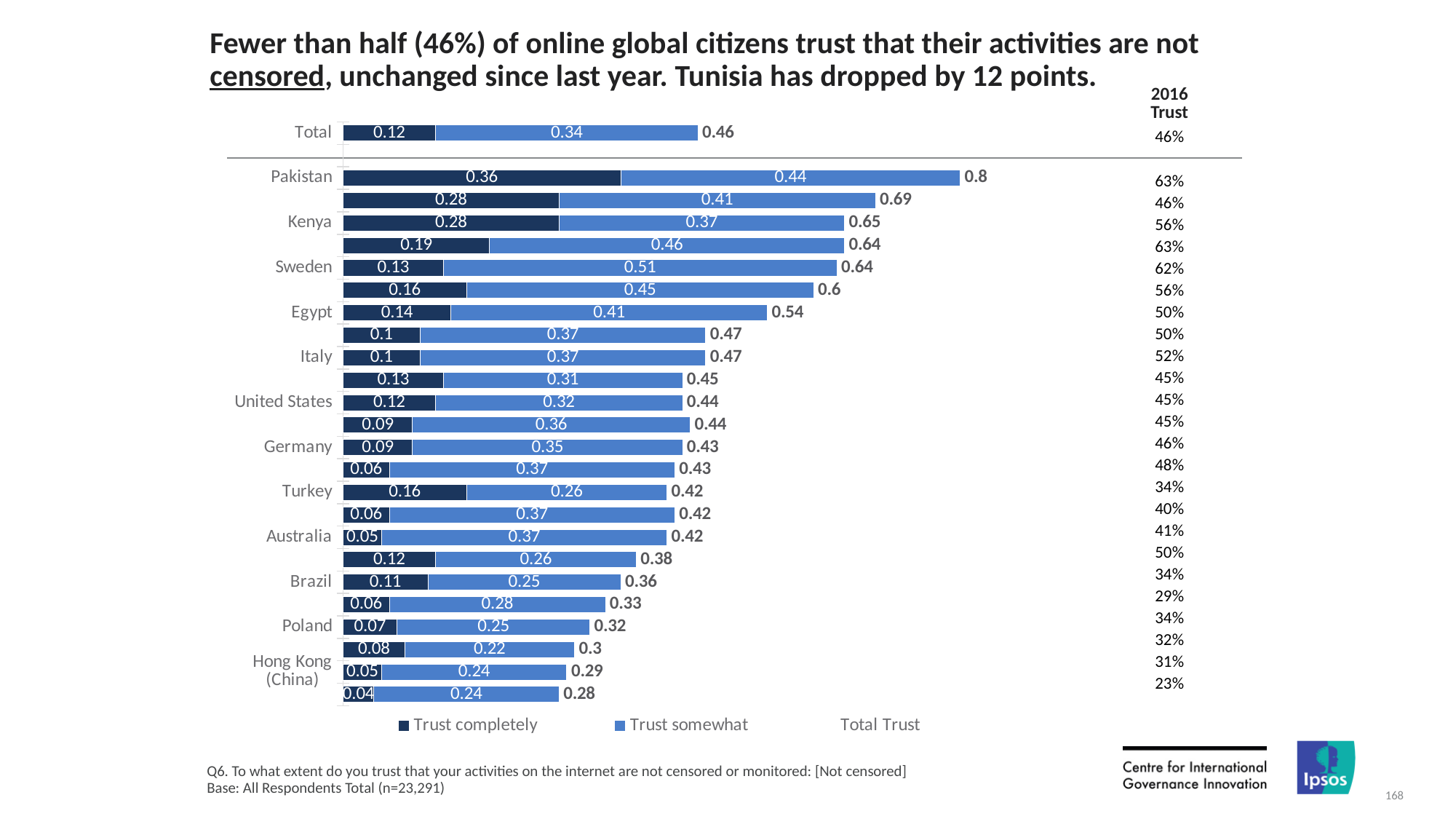
What is the 'Trust somewhat' value for Sweden? 0.51 What is the Total Trust value for Egypt? 0.54 What is the 'Trust completely' value for Australia? 0.05 What is the 'Trust completely' value for Pakistan? 0.36 What is the difference between the Total Trust values for Kenya and Germany? 0.22 Which has a larger Total Trust value, Italy or United States? Italy What is the 2016 Trust value shown for the Total row? 46% How many series does the legend list? 3 What kind of chart is shown on the slide? bar chart Which country has the highest Total Trust value? Pakistan What is the total of the stacked bar for Brazil? 0.36 What is the 2016 Trust value shown for Turkey? 34%